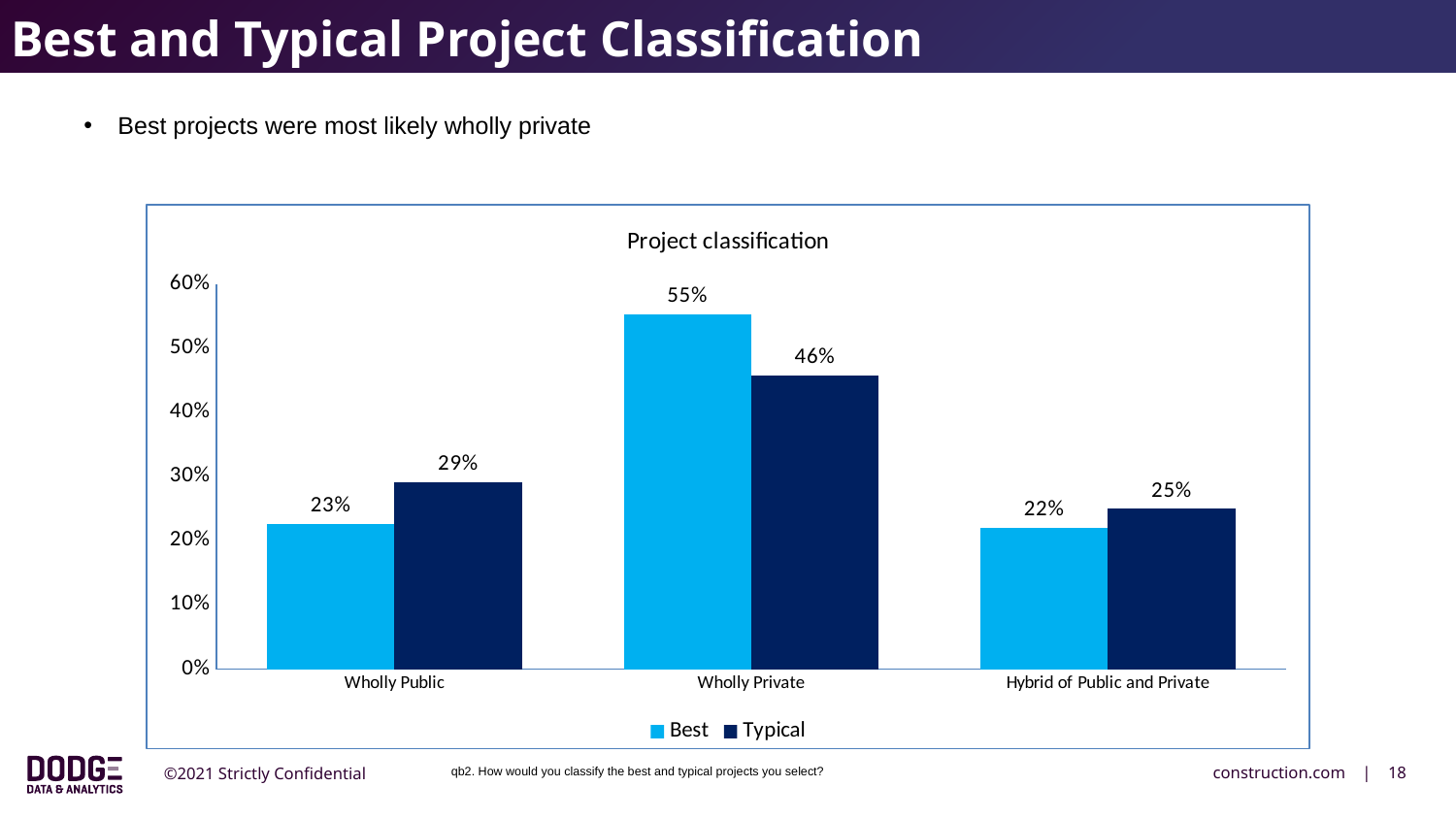
How many series does the legend list? 2 How many categories are shown on the x axis? 3 Which is larger for Wholly Public, the Best value or the Typical value? Typical What is the Best value for Hybrid of Public and Private? 22% What is the Typical value for Hybrid of Public and Private? 25% What is the difference between the Best and Typical values for Wholly Private? 9% What kind of chart is shown on the slide? Bar chart What is the Best value for Wholly Private? 55% What is the Typical value for Wholly Public? 29% Which category has the highest Best value? Wholly Private What is the title of the chart? Project classification Which category has the lowest Typical value? Hybrid of Public and Private